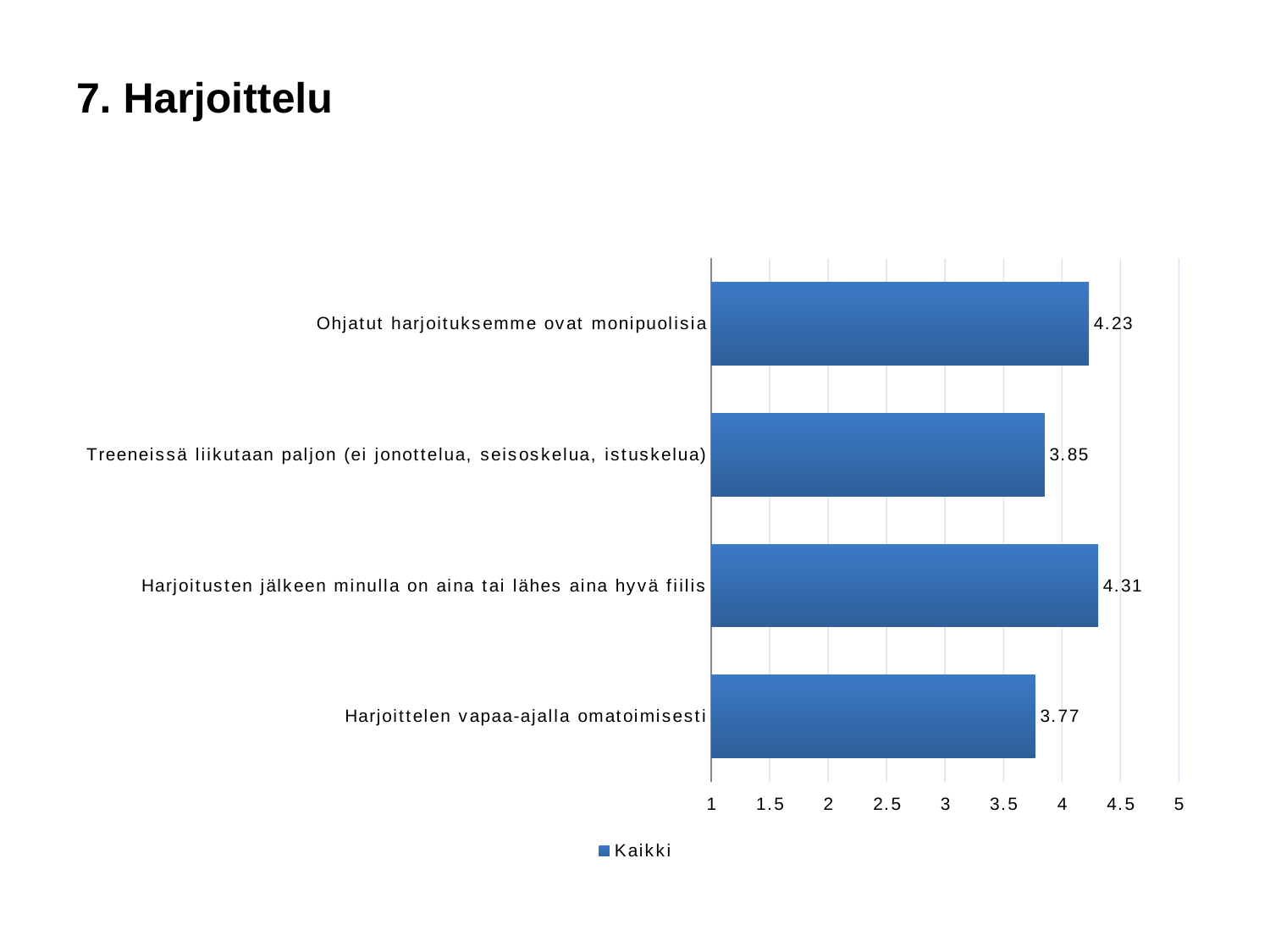
How many categories are shown in the chart? 4 Which is larger: the value for "Ohjatut harjoituksemme ovat monipuolisia" or for "Treeneissä liikutaan paljon (ei jonottelua, seisoskelua, istuskelua)"? Ohjatut harjoituksemme ovat monipuolisia How many series does the legend list? 1 What is the value for "Harjoittelen vapaa-ajalla omatoimisesti"? 3.77 Which category has the lowest value? Harjoittelen vapaa-ajalla omatoimisesti What is the value for "Treeneissä liikutaan paljon (ei jonottelua, seisoskelua, istuskelua)"? 3.85 Which category has the highest value? Harjoitusten jälkeen minulla on aina tai lähes aina hyvä fiilis What kind of chart is shown on the slide? bar chart What is the value for "Ohjatut harjoituksemme ovat monipuolisia"? 4.23 What is the name of the series shown in the legend? Kaikki Is the value for "Harjoittelen vapaa-ajalla omatoimisesti" greater or less than 4? less What is the difference between the values for "Harjoitusten jälkeen minulla on aina tai lähes aina hyvä fiilis" and "Harjoittelen vapaa-ajalla omatoimisesti"? 0.54